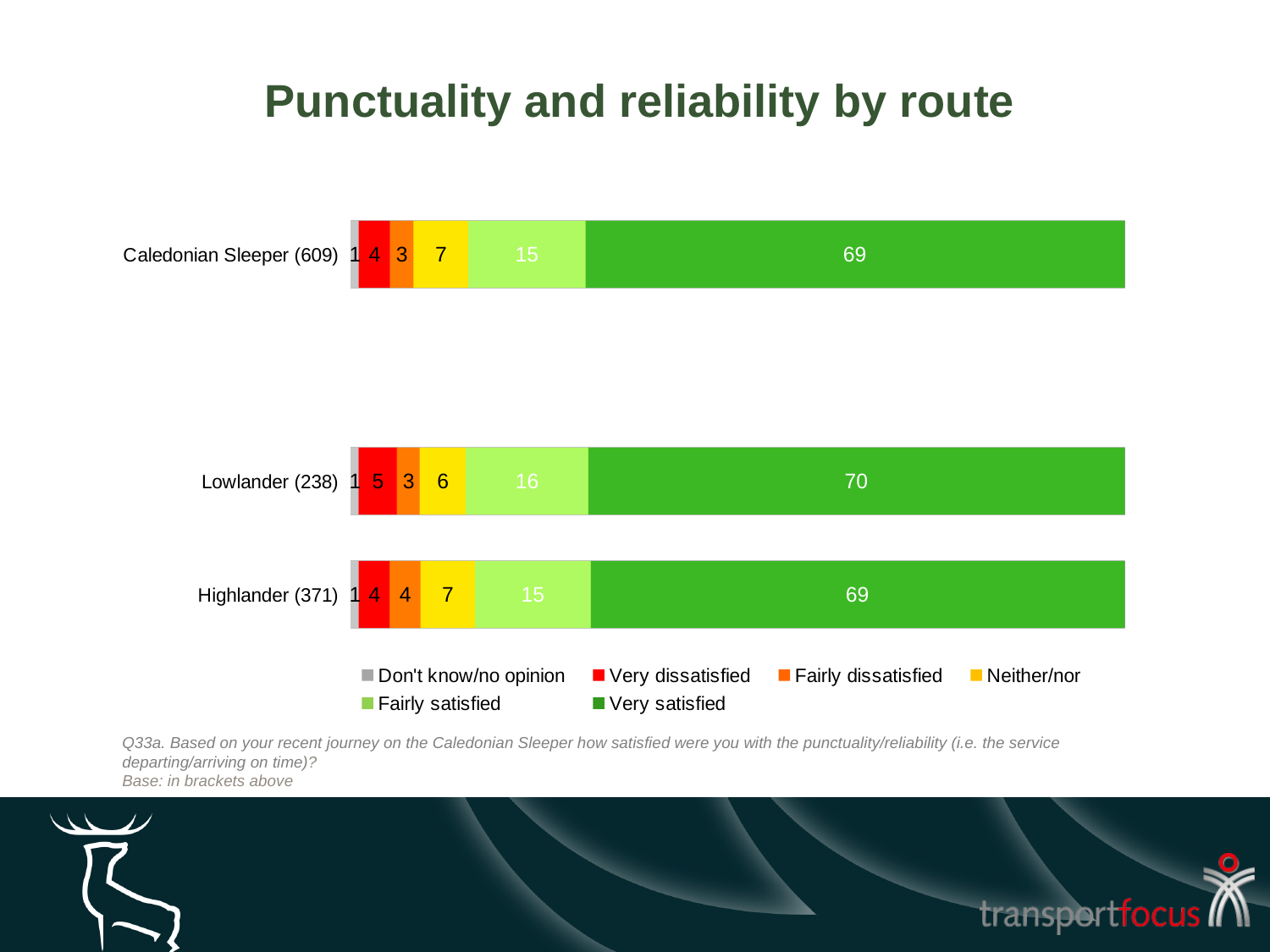
What is the Fairly satisfied value for Caledonian Sleeper (609)? 15 What is the Fairly dissatisfied value for Highlander (371)? 4 Which is larger: the Very dissatisfied value for Lowlander (238) or for Caledonian Sleeper (609)? Lowlander (238) What is the Very satisfied value for Lowlander (238)? 70 Which route has the highest Very satisfied value? Lowlander (238) What is the title of the chart? Punctuality and reliability by route How many series does the legend list? 6 What is the difference between the Fairly satisfied values for Lowlander (238) and Highlander (371)? 1 What is the Very dissatisfied value for Lowlander (238)? 5 Which route has the lowest Neither/nor value? Lowlander (238) How many routes (categories) are plotted in the chart? 3 What kind of chart is shown on the slide? Stacked bar chart